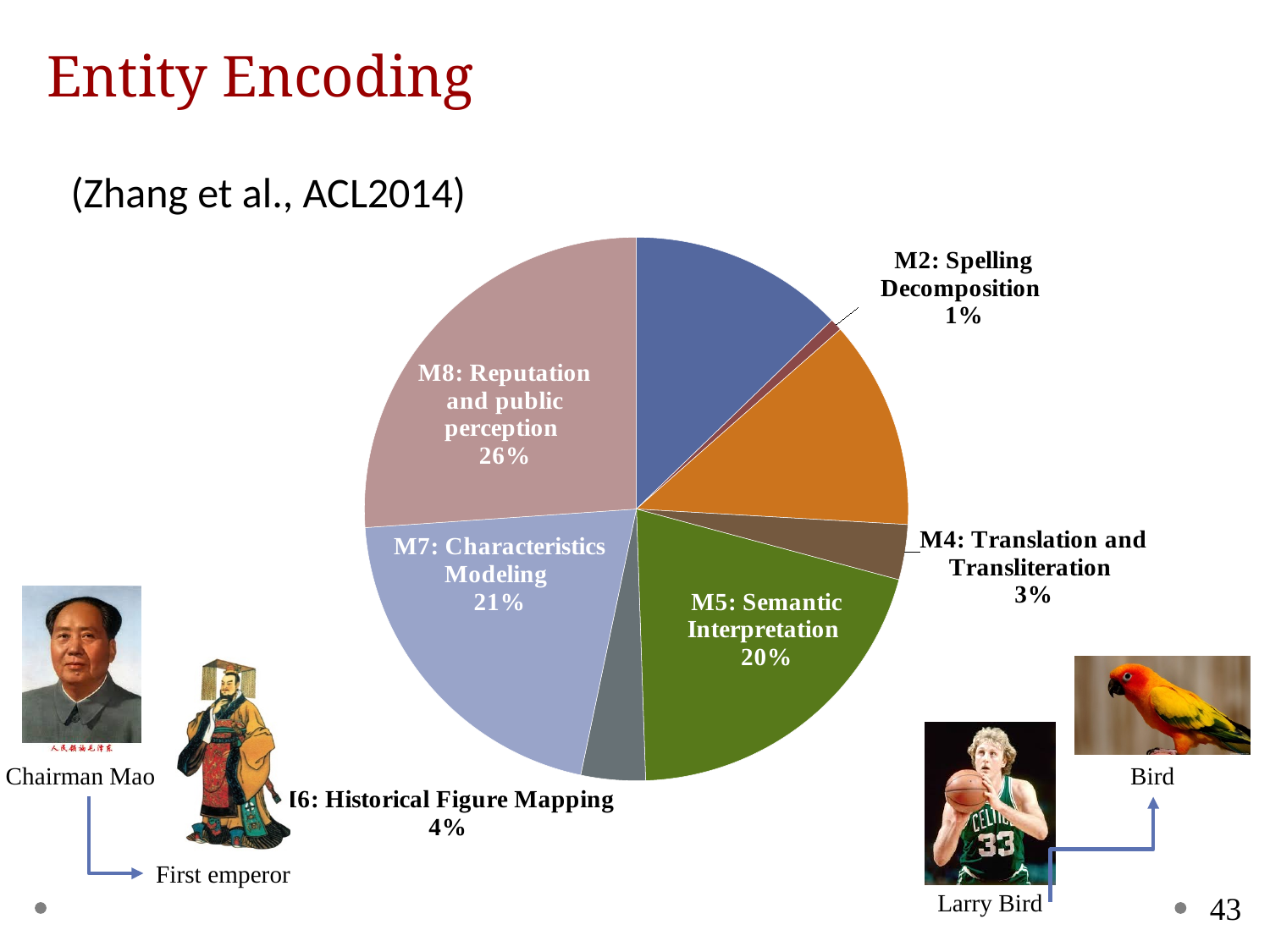
How many slices does the pie chart have? 8 What percentage does the M8: Reputation and public perception slice represent? 26% What colour is the M5: Semantic Interpretation slice? green What percentage is shown for M2: Spelling Decomposition? 1% Which labeled slice has the largest share of the pie? M8: Reputation and public perception What percentage is shown for M4: Translation and Transliteration? 3% What is the difference in percentage points between M8: Reputation and public perception and M7: Characteristics Modeling? 5% What percentage is shown for M7: Characteristics Modeling? 21% Which labeled slice has the smallest share of the pie? M2: Spelling Decomposition What kind of chart is shown on the slide? pie chart What percentage is shown for M5: Semantic Interpretation? 20% Which is larger, the share for M7: Characteristics Modeling or the share for M5: Semantic Interpretation? M7: Characteristics Modeling